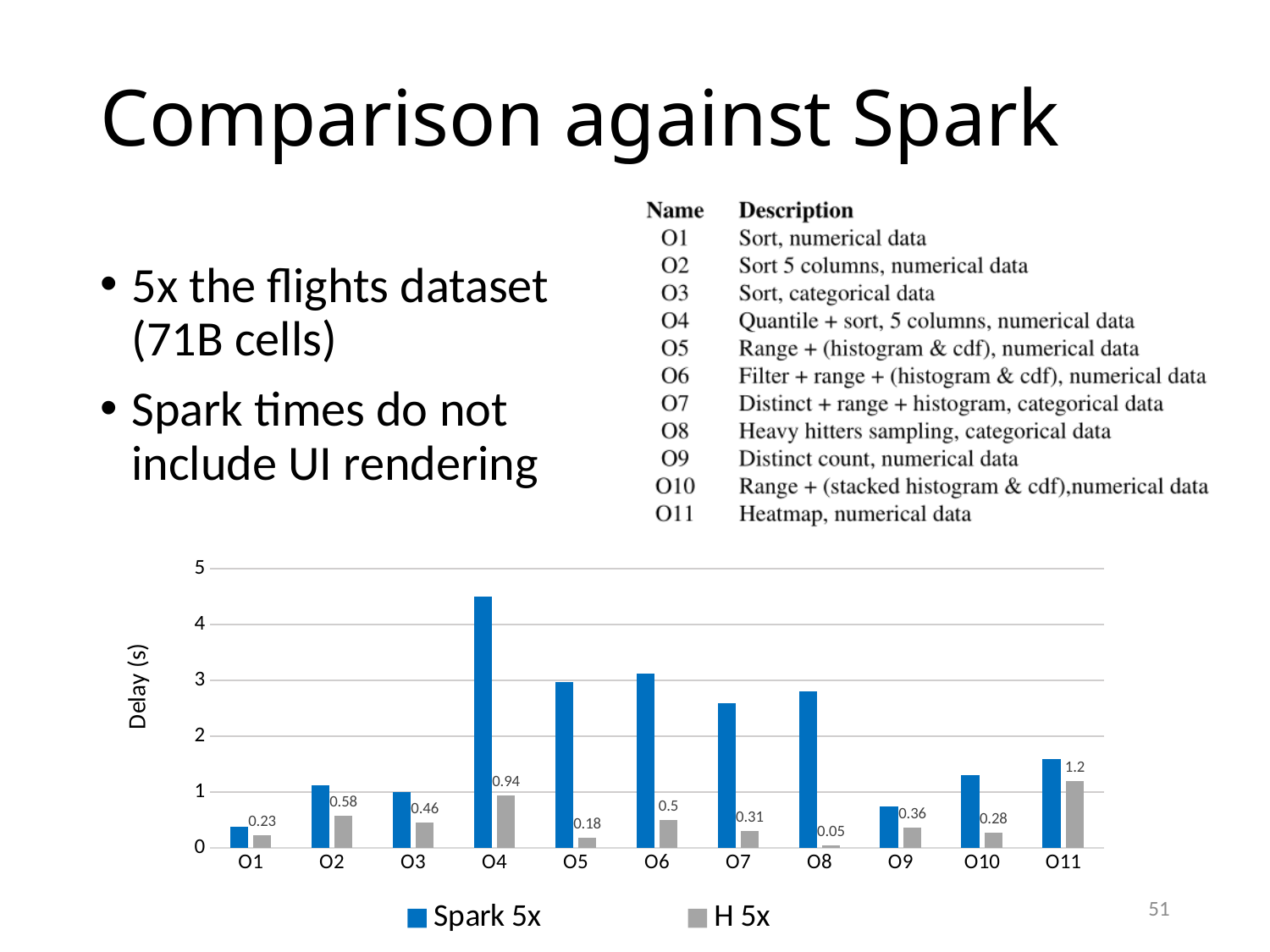
Which category has the lowest H 5x value? O8 Which category has the highest H 5x value? O11 Is the Spark 5x value for O4 greater or less than 4? greater What is the H 5x value for O11? 1.2 What is the H 5x value for O4? 0.94 What is the label of the y axis? Delay (s) How many series does the legend list? 2 Which is larger, the H 5x value for O2 or for O3? O2 How many categories are shown on the x axis? 11 Which category has the highest Spark 5x value? O4 What is the difference between the H 5x values for O4 and O1? 0.71 What is the H 5x value for O8? 0.05